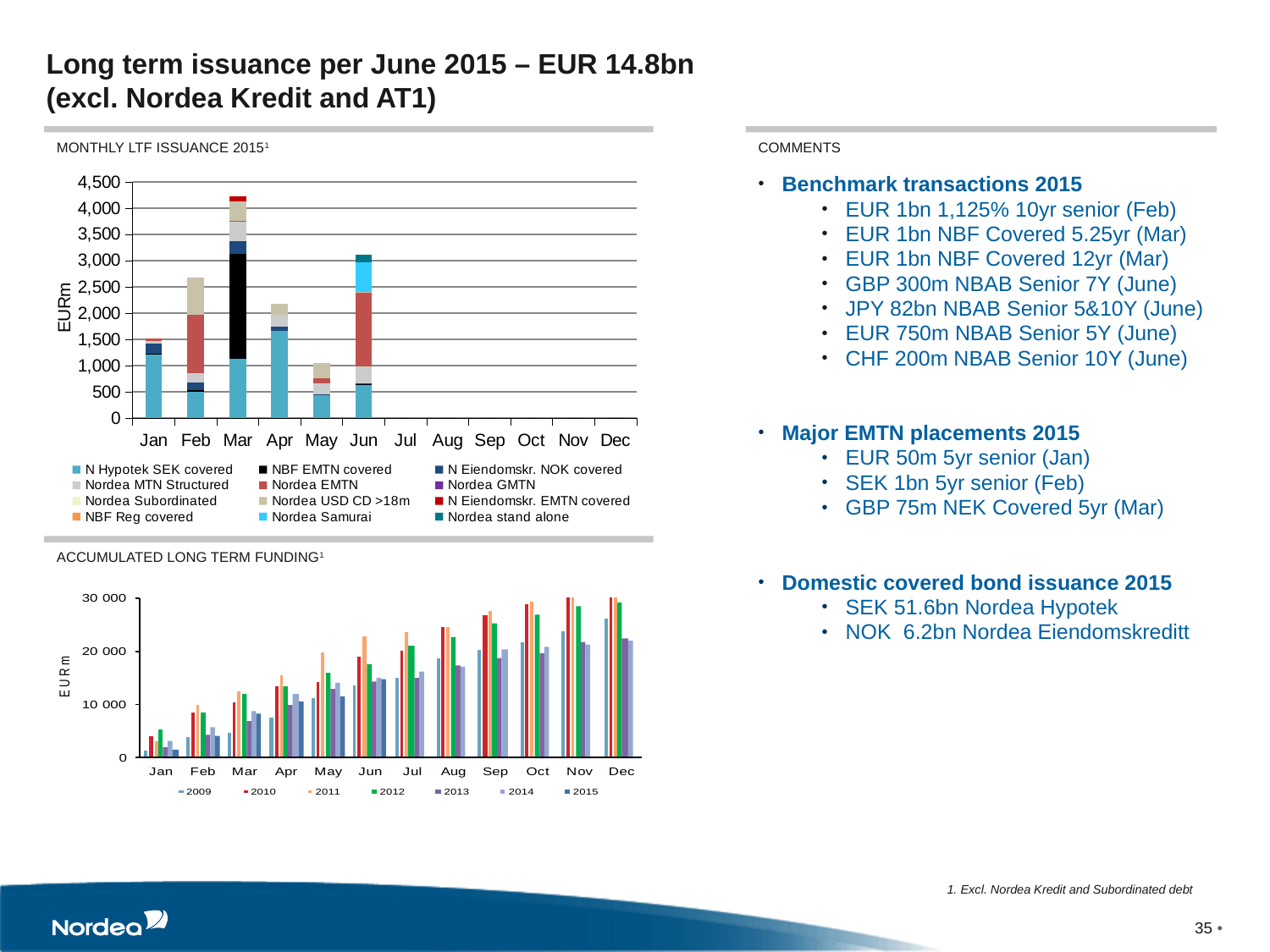
How many series does the legend of the ACCUMULATED LONG TERM FUNDING chart list? 7 In the ACCUMULATED LONG TERM FUNDING chart, do the values for each year generally rise or fall from Jan to Dec? rise In the MONTHLY LTF ISSUANCE 2015 chart, is the total for May greater or less than 1,500? less What type of chart is the MONTHLY LTF ISSUANCE 2015 chart? Stacked bar chart In the MONTHLY LTF ISSUANCE 2015 chart, is the total for Mar greater or less than 4,000? greater In the MONTHLY LTF ISSUANCE 2015 chart, which month has the highest total issuance? Mar In the MONTHLY LTF ISSUANCE 2015 chart, is the total for Feb greater or less than 3,000? less How many months are shown on the x axis of the ACCUMULATED LONG TERM FUNDING chart? 12 How many series does the legend of the MONTHLY LTF ISSUANCE 2015 chart list? 12 In the MONTHLY LTF ISSUANCE 2015 chart, which total is larger, Jan or May? Jan What is the y-axis unit label on the MONTHLY LTF ISSUANCE 2015 chart? EURm